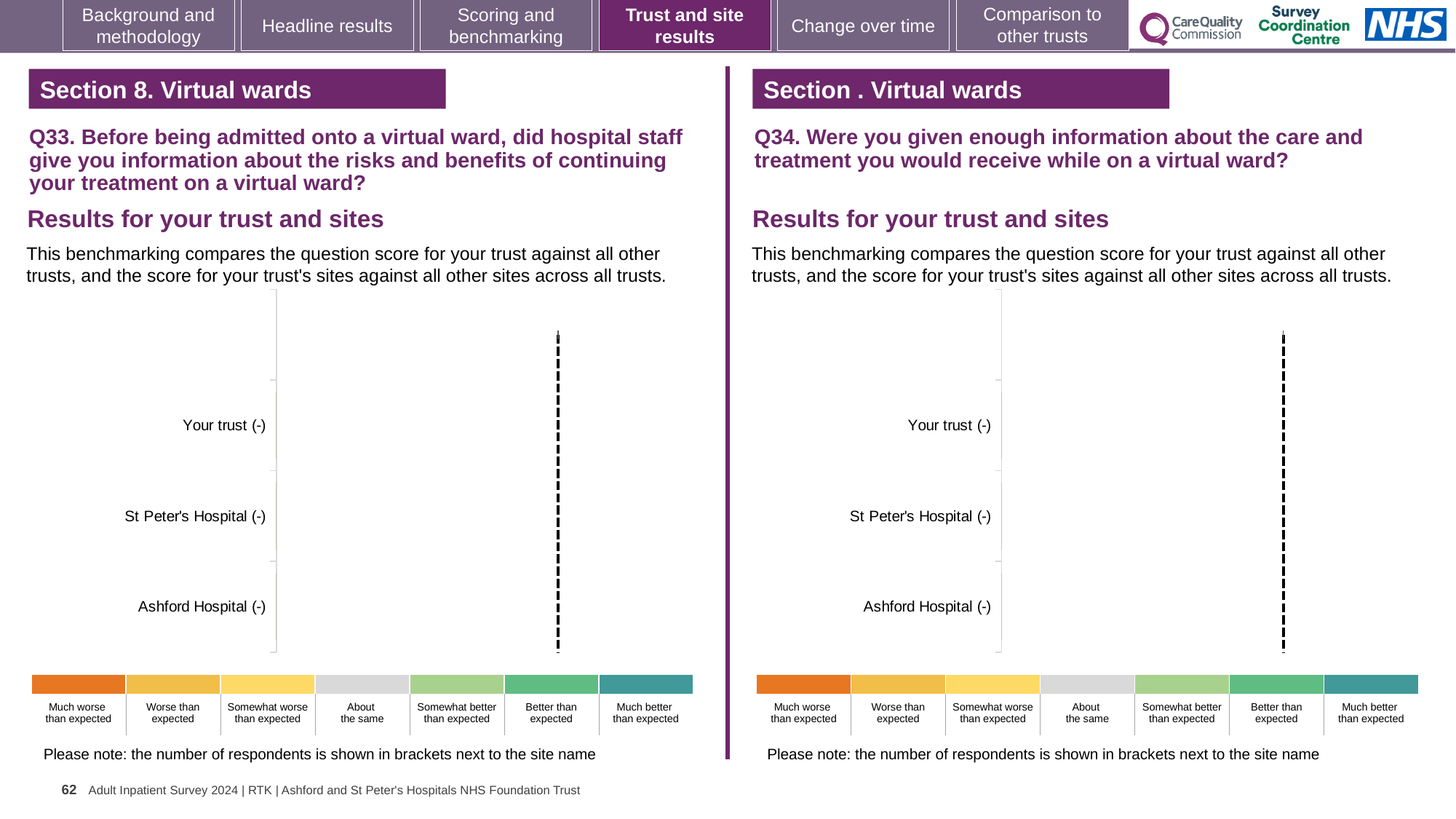
On the Q34 chart on the right, how many colour bands are shown in the scale beneath the chart? 7 On the Q33 chart on the left, what number of respondents is shown in brackets next to 'Your trust'? - On the Q33 chart on the left, what is the label of the leftmost (orange) band in the scale beneath the chart? Much worse than expected On the Q33 chart on the left, how many categories are listed on the vertical axis? 3 On the Q33 chart on the left, what are the three categories listed on the vertical axis? Your trust, St Peter's Hospital, Ashford Hospital On the Q34 chart on the right, what number of respondents is shown in brackets next to 'Ashford Hospital'? - On the Q34 chart on the right, what is the label of the grey band in the scale beneath the chart? About the same On the Q33 chart on the left, are any scores plotted for the trust or its sites? No On the Q34 chart on the right, how many categories are listed on the vertical axis? 3